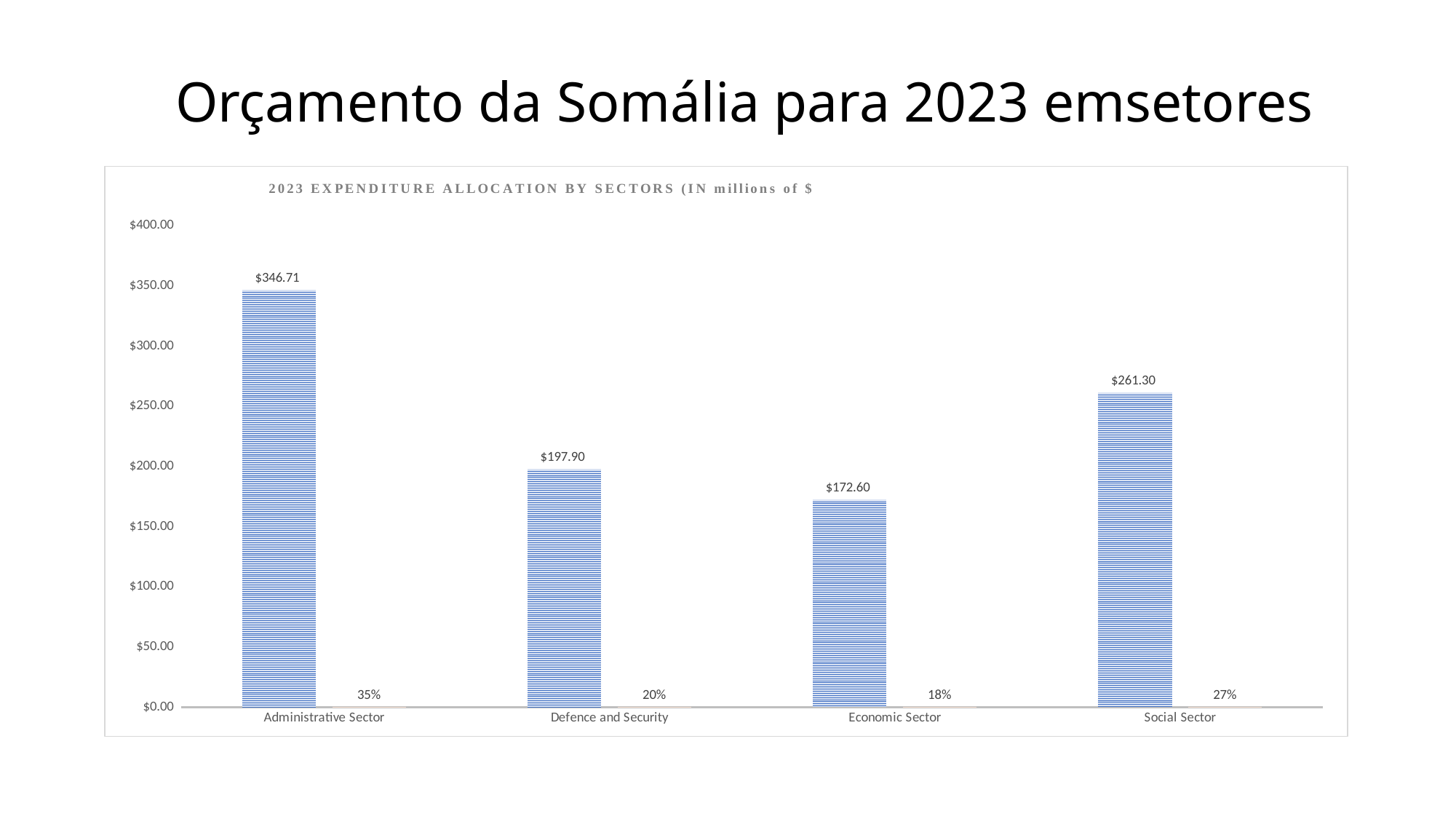
How many sectors are shown on the x axis? 4 What kind of chart is shown on the slide? Bar chart What is the expenditure allocation for Defence and Security? $197.90 What is the expenditure allocation for the Administrative Sector? $346.71 What percentage share is shown for the Social Sector? 27% What is the expenditure allocation for the Economic Sector? $172.60 What is the expenditure allocation for the Social Sector? $261.30 Which sector has the highest expenditure allocation? Administrative Sector Which has a larger allocation, Defence and Security or the Economic Sector? Defence and Security What is the difference between the Administrative Sector and Social Sector allocations? $85.41 What is the title of the chart? 2023 EXPENDITURE ALLOCATION BY SECTORS (IN millions of $ Which sector has the lowest expenditure allocation? Economic Sector